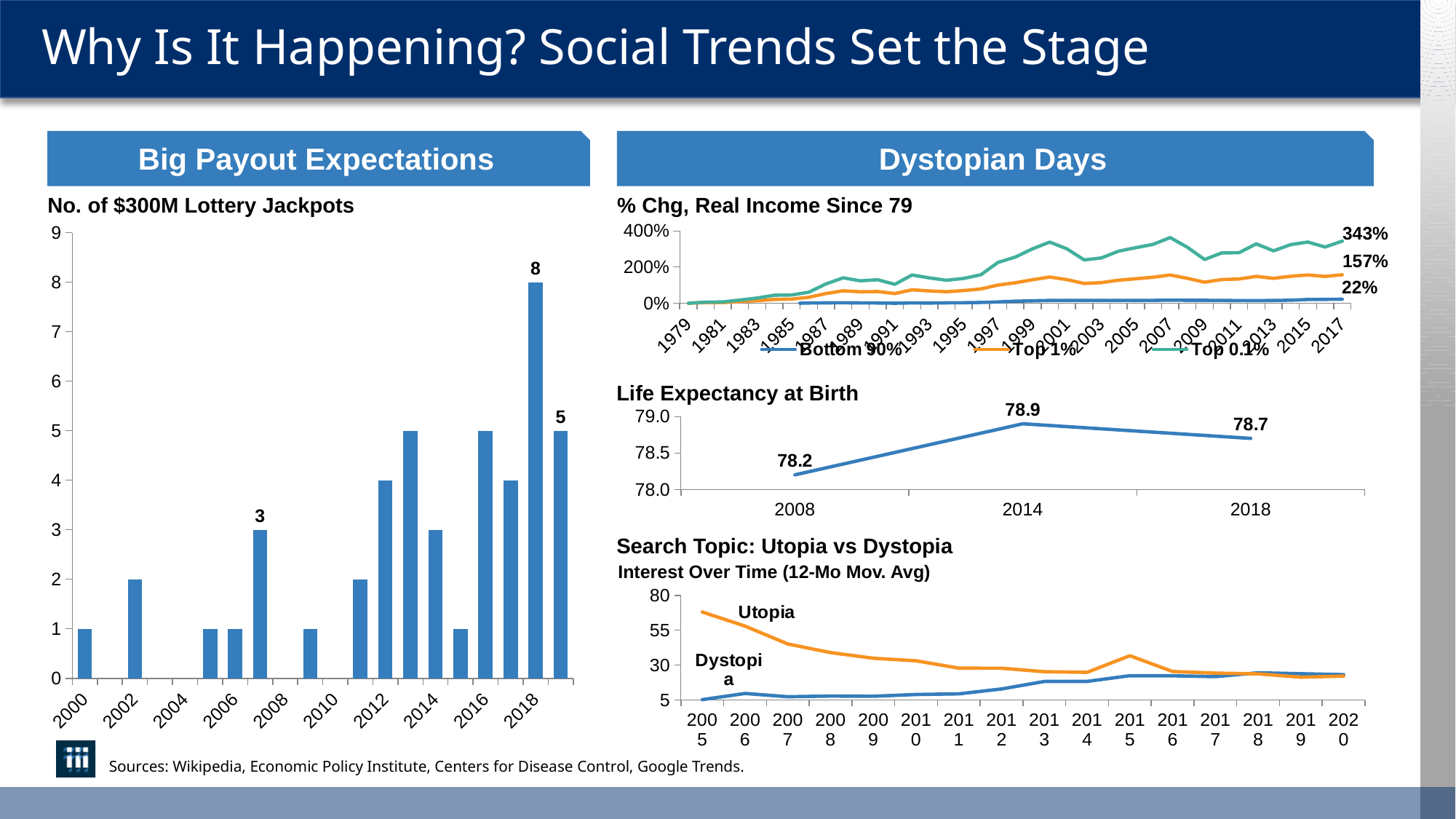
How many series does the legend of the '% Chg, Real Income Since 79' chart list? 3 In the 'Life Expectancy at Birth' chart, what is the difference between the 2014 and 2008 values? 0.7 In the 'No. of $300M Lottery Jackpots' chart, which year has the highest number of jackpots? 2018 In the 'No. of $300M Lottery Jackpots' chart, how many $300M lottery jackpots were there in 2018? 8 What kind of chart is the 'No. of $300M Lottery Jackpots' chart? Bar chart In the 'Search Topic: Utopia vs Dystopia' chart, does the Utopia line rise or fall from 2005 to 2020? Fall In the 'No. of $300M Lottery Jackpots' chart, what is the value for 2007? 3 In the 'No. of $300M Lottery Jackpots' chart, what is the difference between the 2018 and 2019 values? 3 In the '% Chg, Real Income Since 79' chart, which series has the highest value in 2017? Top 0.1% In the '% Chg, Real Income Since 79' chart, what is the final value shown for the Top 0.1% series? 343% In the 'Life Expectancy at Birth' chart, what is the value for 2014? 78.9 In the 'Search Topic: Utopia vs Dystopia' chart, is the Utopia value in 2005 greater or less than 55? greater